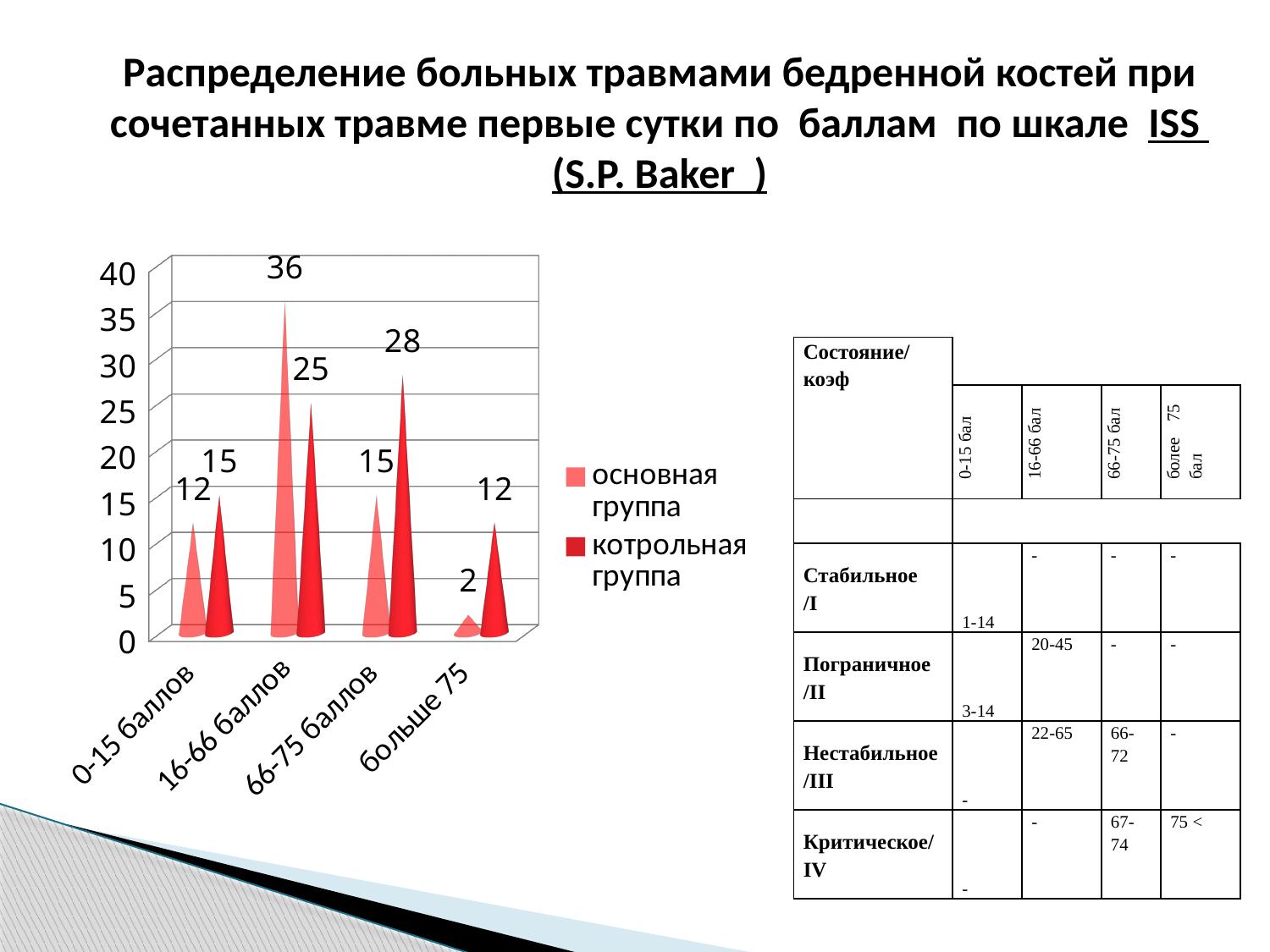
How many series does the chart legend list? 2 What is the value for the основная группа series in the 16-66 баллов category? 36 Which category has the lowest value for the котрольная группа series? больше 75 What is the total of the основная группа and котрольная группа values in the 0-15 баллов category? 27 What is the value for the котрольная группа series in the 66-75 баллов category? 28 How many categories are shown on the x axis of the chart? 4 What is the value for the котрольная группа series in the 0-15 баллов category? 15 What is the difference between the основная группа and котрольная группа values in the 16-66 баллов category? 11 Which category has the highest value for the основная группа series? 16-66 баллов In the 66-75 баллов category, which series has the larger value, основная группа or котрольная группа? котрольная группа What is the value for the основная группа series in the больше 75 category? 2 What kind of chart is shown on the slide? bar chart